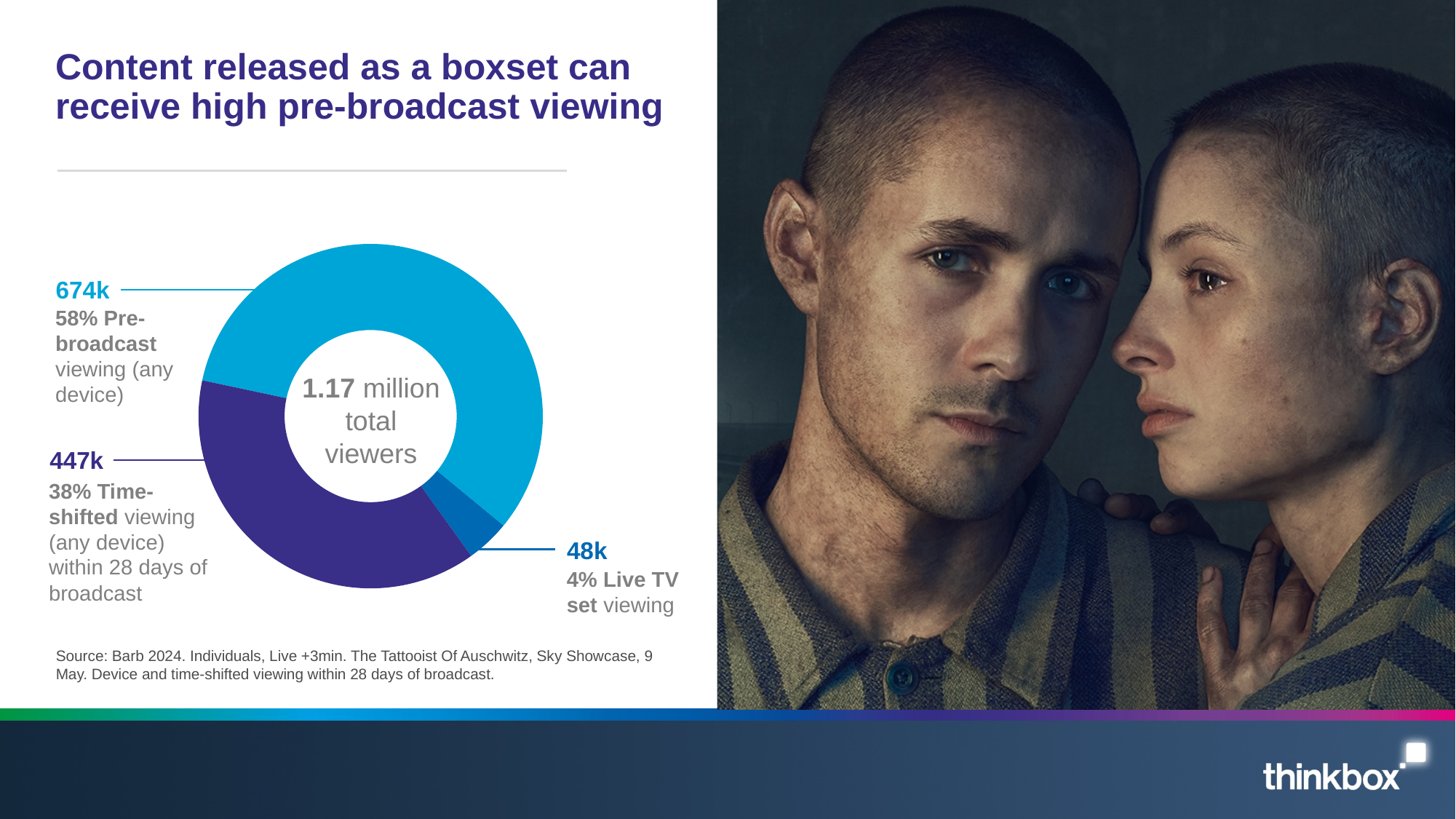
How many segments does the doughnut chart have? 3 How many viewers does the chart show for live TV set viewing? 48k How many viewers does the chart show for time-shifted viewing (any device) within 28 days of broadcast? 447k What is the difference in viewers between pre-broadcast viewing and time-shifted viewing? 227k How many viewers does the chart show for pre-broadcast viewing (any device)? 674k What kind of chart is shown on the slide? Doughnut (pie) chart What share of total viewing is pre-broadcast viewing? 58% What total number of viewers is shown in the centre of the chart? 1.17 million Which is larger: time-shifted viewing or live TV set viewing? Time-shifted viewing Which viewing category has the largest share of the chart? Pre-broadcast viewing (any device) Which viewing category has the smallest share of the chart? Live TV set viewing What share of total viewing is live TV set viewing? 4%